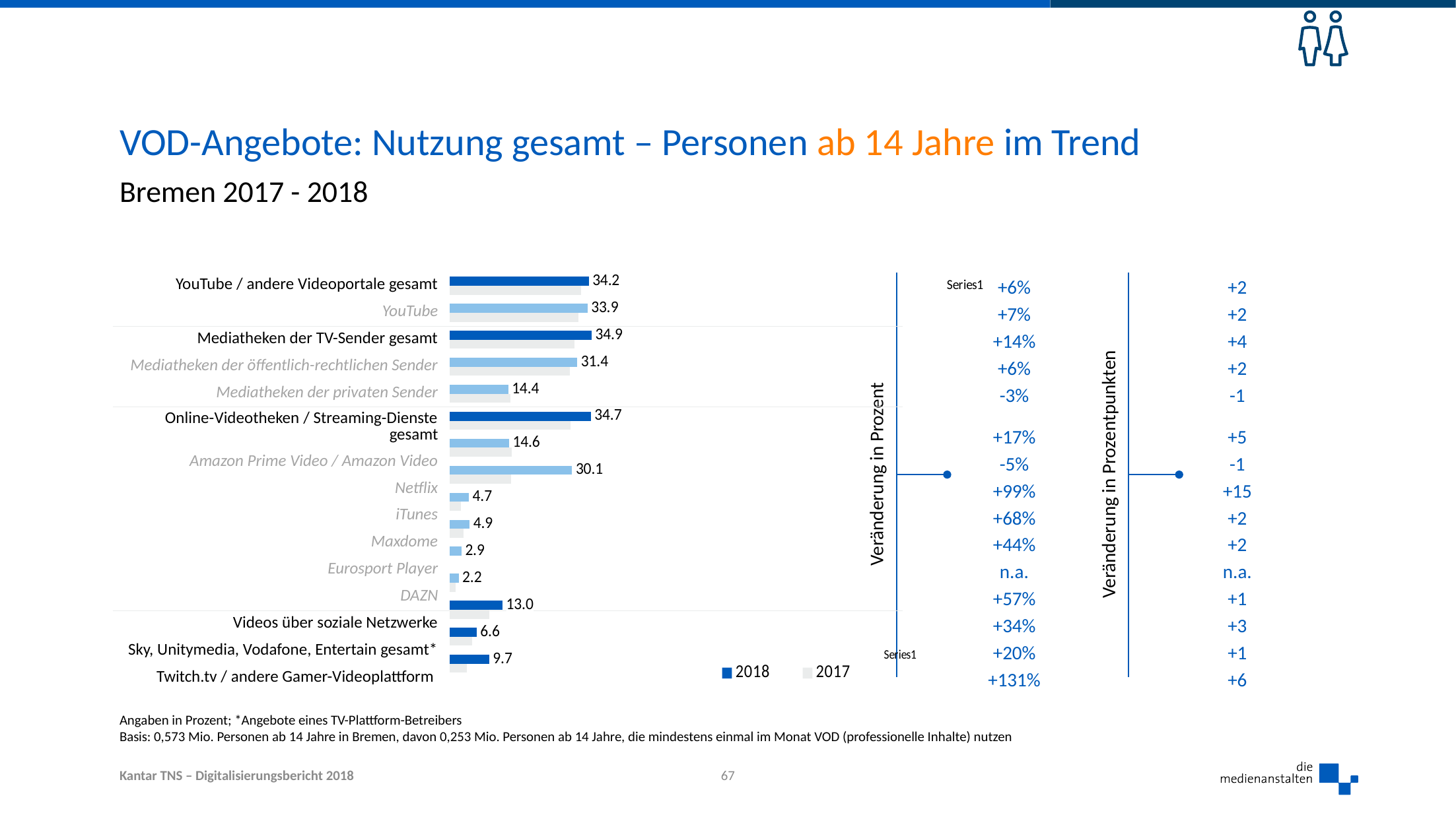
What is the difference between the 2018 values for Mediatheken der öffentlich-rechtlichen Sender and Mediatheken der privaten Sender? 17.0 What kind of chart is shown on the slide? bar chart What is the 2018 value for YouTube / andere Videoportale gesamt? 34.2 Which two years are listed in the chart legend? 2018 and 2017 What is the 2018 value for Online-Videotheken / Streaming-Dienste gesamt? 34.7 Which category has the highest 2018 value? Mediatheken der TV-Sender gesamt What is the smallest 2018 value printed on the chart? 2.2 How many series does the chart legend list? 2 Which has the larger 2018 value: YouTube / andere Videoportale gesamt or Online-Videotheken / Streaming-Dienste gesamt? Online-Videotheken / Streaming-Dienste gesamt What is the 2018 value for YouTube? 33.9 What is the 2018 value for Mediatheken der privaten Sender? 14.4 What is the 2018 value for Mediatheken der TV-Sender gesamt? 34.9